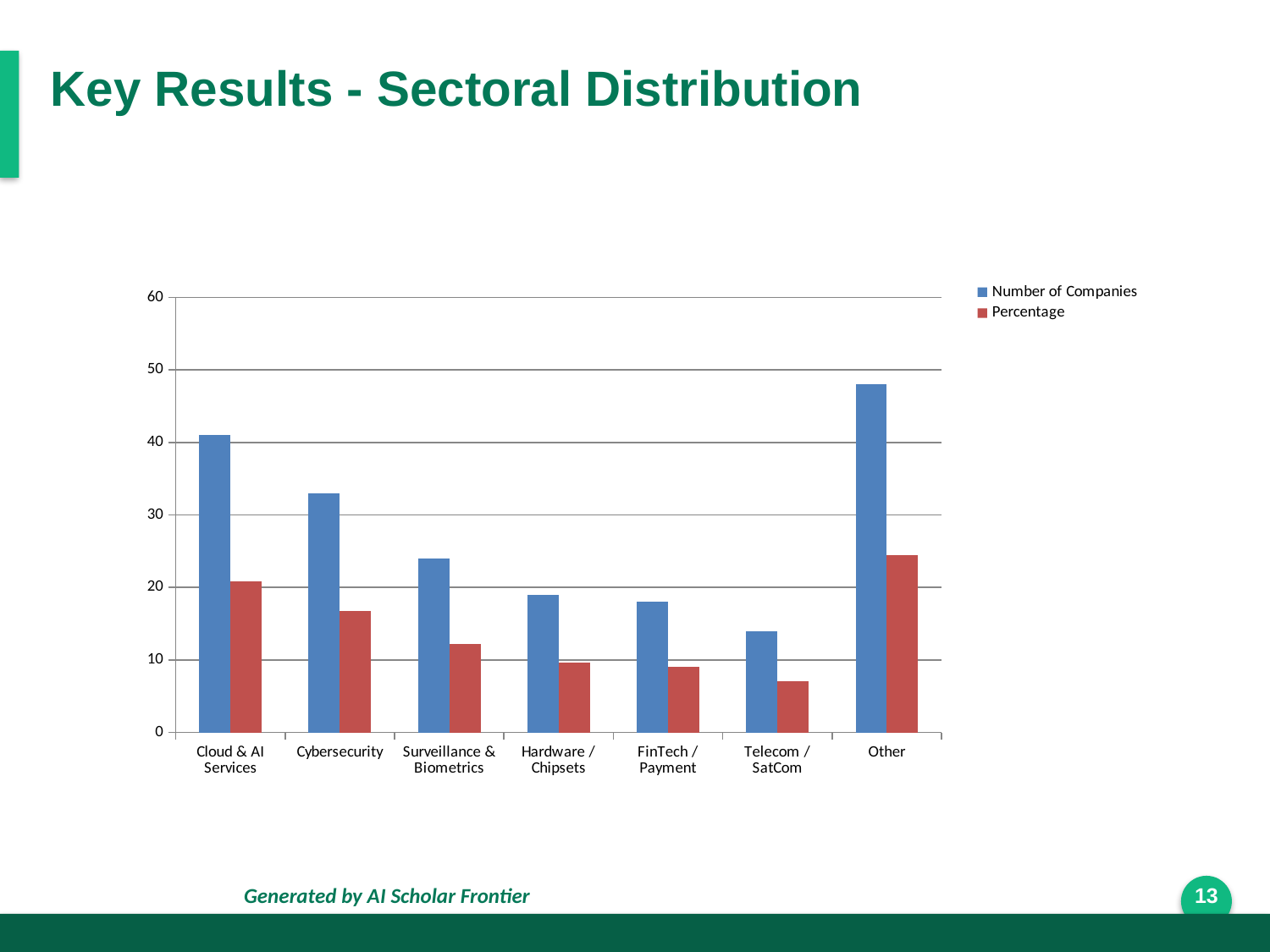
Is the Number of Companies for Other greater or less than 50? less What kind of chart is shown on the slide? bar chart What are the two series named in the legend? Number of Companies and Percentage Which has a larger Number of Companies, Cloud & AI Services or Cybersecurity? Cloud & AI Services Which sector has the lowest Number of Companies? Telecom / SatCom Is the Percentage for Surveillance & Biometrics greater or less than 10? greater How many series does the legend list? 2 Which sector has the highest Number of Companies? Other Which sector has the highest Percentage? Other Which sector has the lowest Percentage? Telecom / SatCom Is the Number of Companies for Cybersecurity greater or less than 30? greater How many sector categories are shown on the x axis? 7